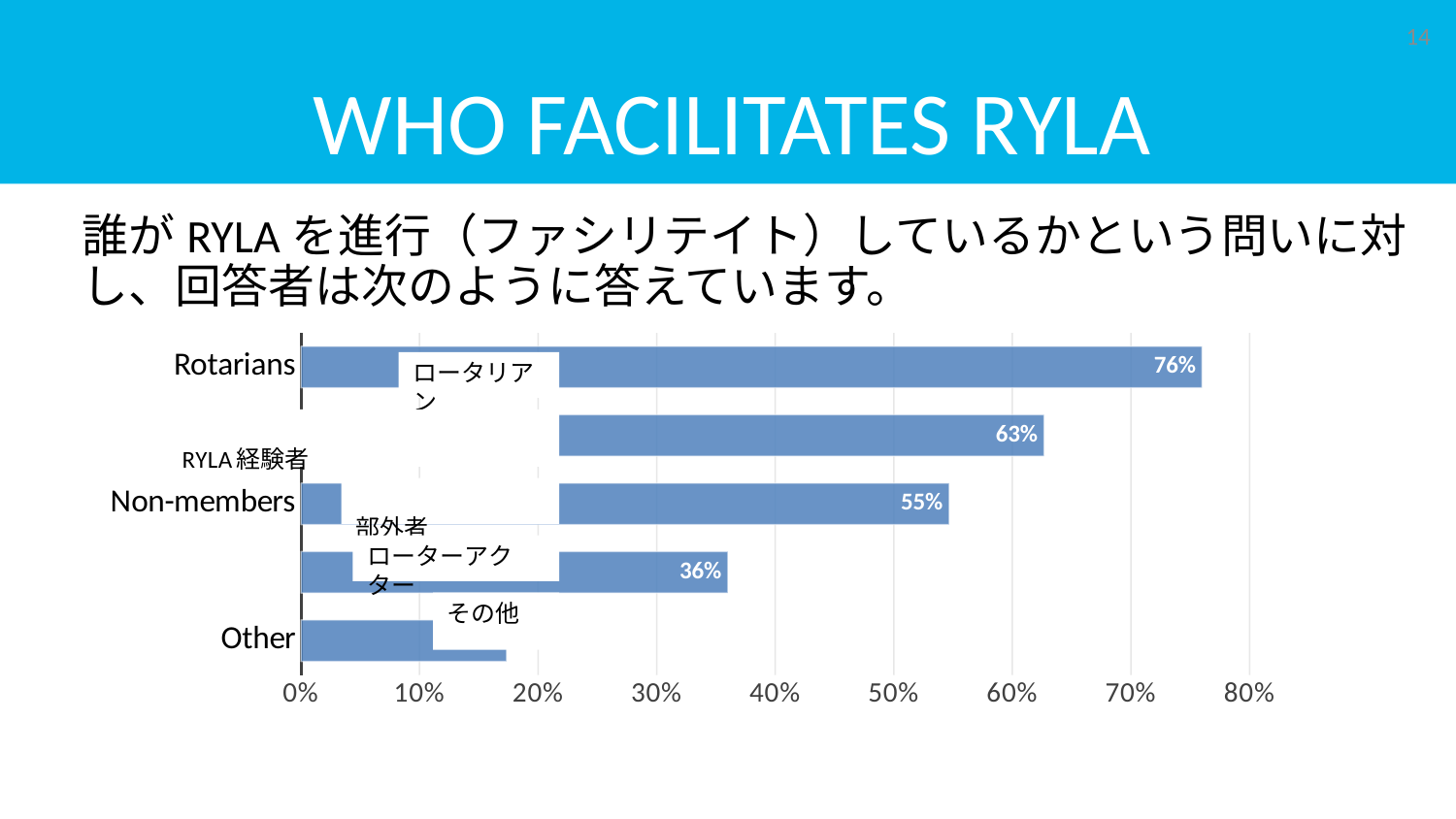
What is the value shown for the bar labelled ローターアクター? 36% How many categories (bars) are shown in the chart? 5 What percentage of respondents said Rotarians facilitate RYLA? 76% What is the difference between the RYLA経験者 value and the ローターアクター value? 27% Which is larger, the value for Non-members or the value for RYLA経験者? RYLA経験者 Which category has the lowest value in the chart? Other Is the value for Other greater or less than 20%? less How much higher is the value for Rotarians than for Non-members? 21% What is the value shown for the bar labelled RYLA経験者? 63% What is the value shown for Non-members? 55% What kind of chart is shown on the slide? bar chart Which category has the highest value in the chart? Rotarians